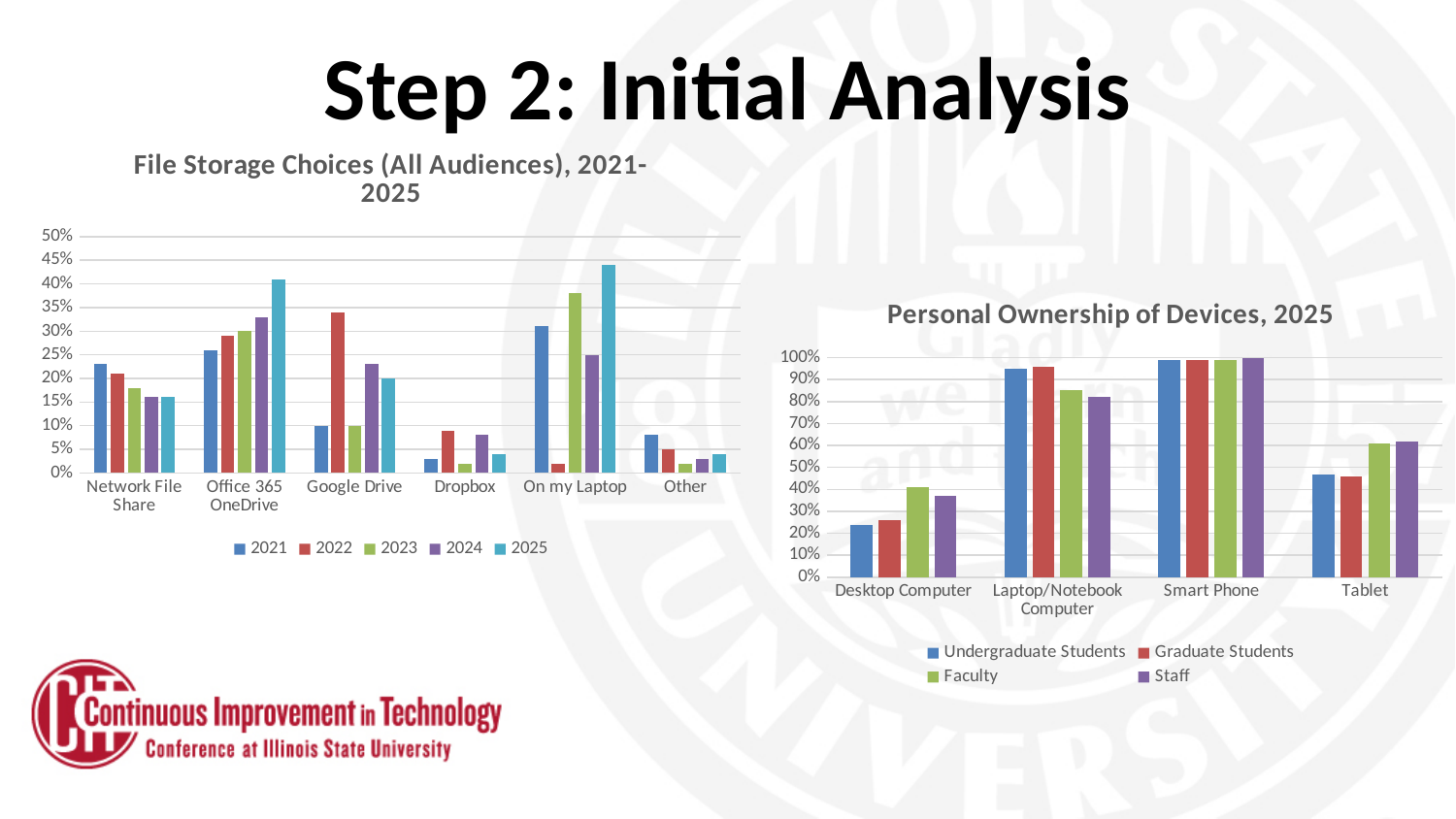
In the 'File Storage Choices (All Audiences), 2021-2025' chart, how many series does the legend list? 5 In the 'File Storage Choices (All Audiences), 2021-2025' chart, which is larger for Google Drive, the 2021 value or the 2022 value? 2022 What kind of chart is the 'File Storage Choices (All Audiences), 2021-2025' chart? bar chart In the 'Personal Ownership of Devices, 2025' chart, which group has the highest value for Desktop Computer? Faculty In the 'File Storage Choices (All Audiences), 2021-2025' chart, how many storage categories are shown on the x axis? 6 In the 'File Storage Choices (All Audiences), 2021-2025' chart, is the 2025 value for Office 365 OneDrive greater or less than 35%? greater In the 'Personal Ownership of Devices, 2025' chart, how many device categories are shown on the x axis? 4 In the 'File Storage Choices (All Audiences), 2021-2025' chart, which year has the highest value for Office 365 OneDrive? 2025 In the 'File Storage Choices (All Audiences), 2021-2025' chart, is the 2022 value for On my Laptop greater or less than 5%? less In the 'File Storage Choices (All Audiences), 2021-2025' chart, do the Office 365 OneDrive values rise or fall from 2021 to 2025? rise In the 'Personal Ownership of Devices, 2025' chart, is the Undergraduate Students value for Tablet greater or less than 50%? less In the 'Personal Ownership of Devices, 2025' chart, how many series does the legend list? 4